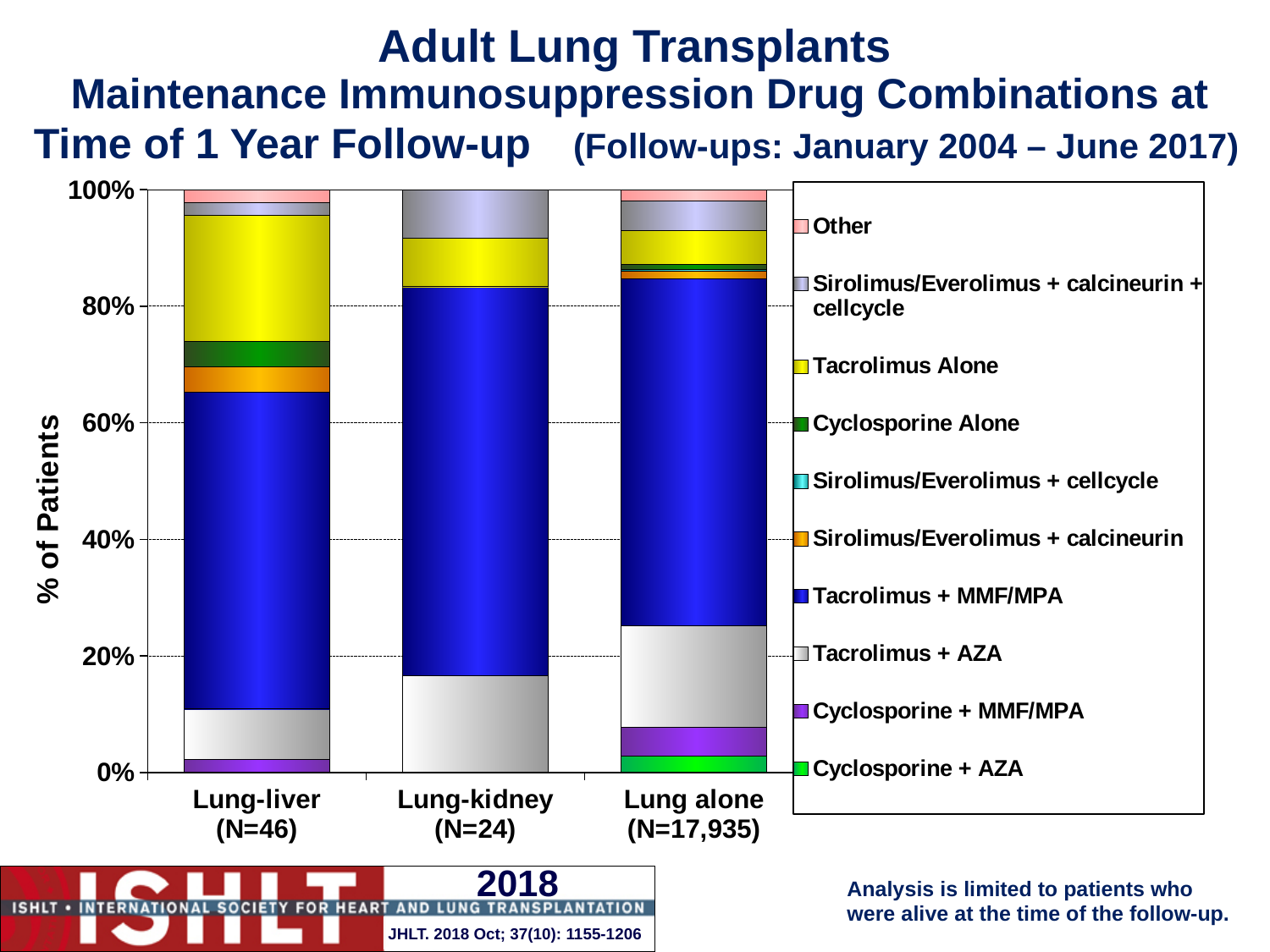
Which transplant category has the largest Tacrolimus Alone share? Lung-liver What is the N shown for the Lung alone category? N=17,935 How many drug combination series does the legend list? 10 Is the Tacrolimus + AZA share for Lung alone greater or less than 20%? less What kind of chart is shown on the slide? Stacked bar chart Is the Tacrolimus Alone share for Lung-liver greater or less than 40%? less Is the Tacrolimus + MMF/MPA share for Lung-kidney greater or less than 60%? greater Which has the larger Tacrolimus + MMF/MPA share, Lung-liver or Lung-kidney? Lung-kidney Which transplant category has the smallest Tacrolimus + AZA share? Lung-liver Which has the larger Tacrolimus + AZA share, Lung-liver or Lung alone? Lung alone How many transplant categories are shown along the x axis? 3